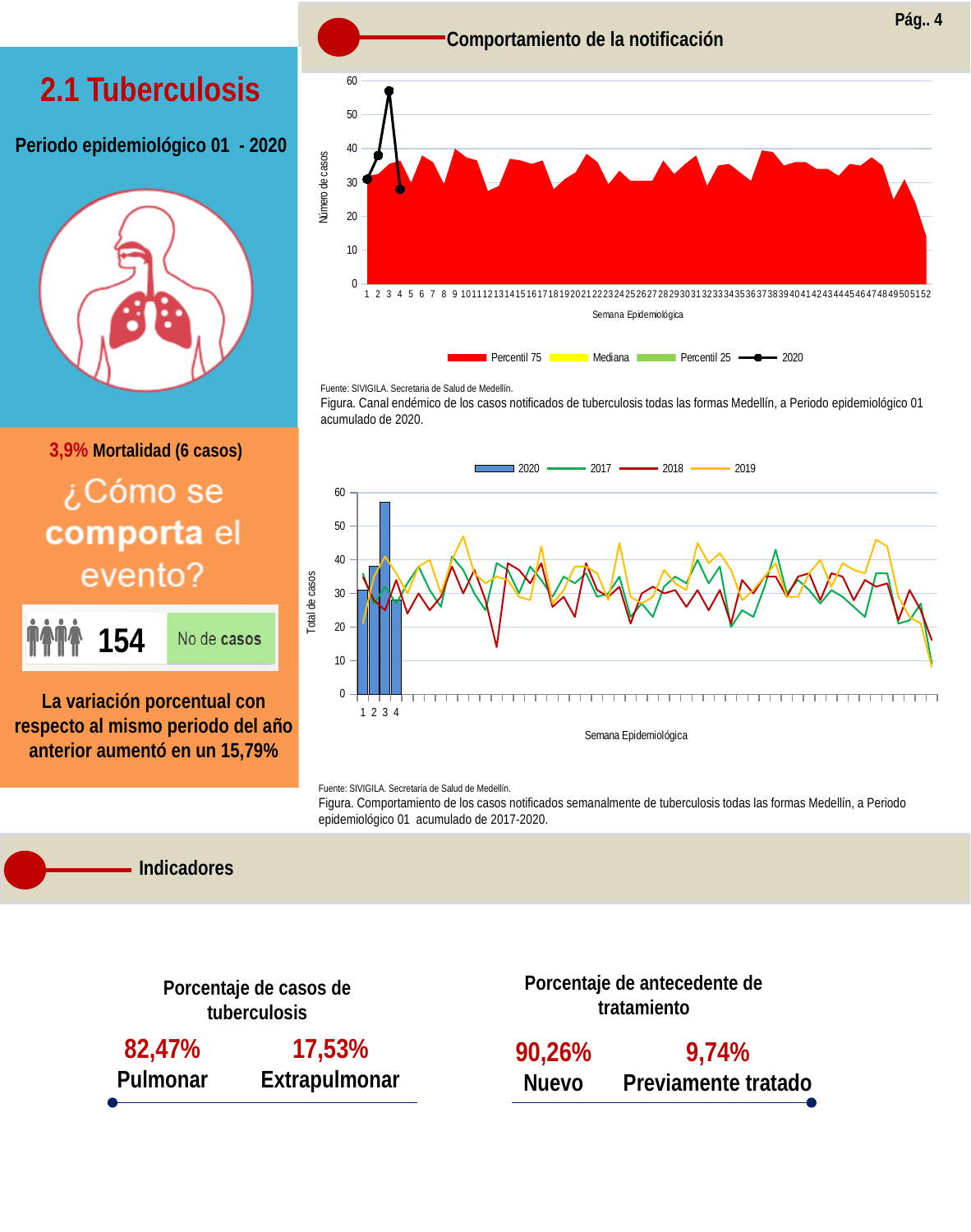
In the bottom chart (Comportamiento de los casos notificados semanalmente), how many series does the legend list? 4 In the top chart (Canal endémico), how many epidemiological weeks are shown on the x axis? 52 In the top chart (Canal endémico), is the 2020 value for week 3 greater or less than 50? greater In the bottom chart (Comportamiento de los casos notificados semanalmente), what is the label of the x axis? Semana Epidemiológica In the top chart (Canal endémico), which is larger for 2020: the value at week 2 or the value at week 4? week 2 In the bottom chart (Comportamiento de los casos notificados semanalmente), which week has the tallest 2020 bar? 3 In the top chart (Canal endémico), how many series does the legend list? 4 In the top chart (Canal endémico), at which epidemiological week does the 2020 line reach its highest value? 3 In the top chart (Canal endémico), is the 2020 value for week 2 greater or less than 40? less In the bottom chart (Comportamiento de los casos notificados semanalmente), how many bars are plotted for 2020? 4 In the top chart (Canal endémico), what is the label of the y axis? Número de casos In the bottom chart (Comportamiento de los casos notificados semanalmente), is the 2020 bar for week 3 greater or less than 50? greater